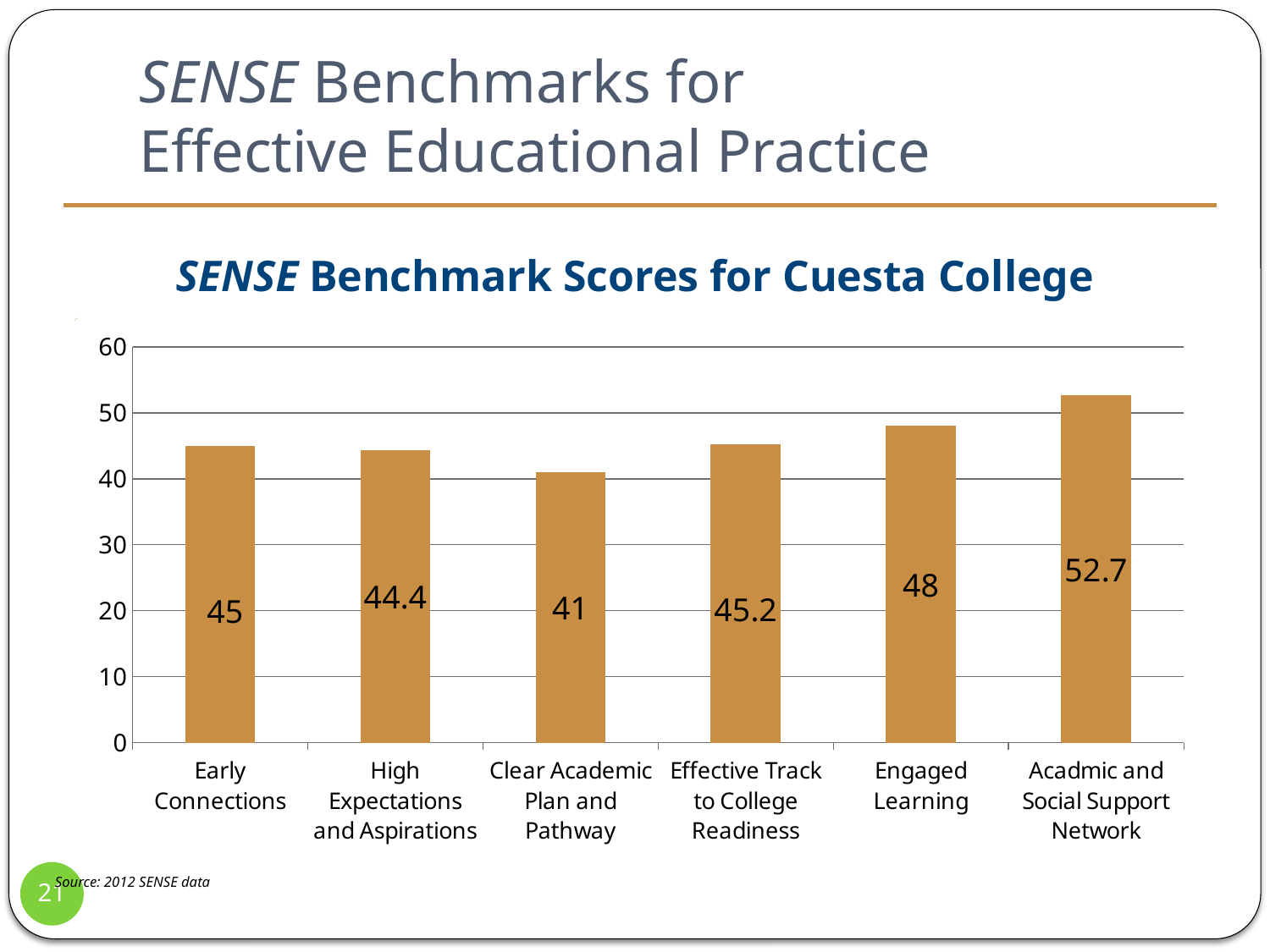
Which has a higher score, Engaged Learning or Early Connections? Engaged Learning Which benchmark has the highest score? Acadmic and Social Support Network What is the score for High Expectations and Aspirations? 44.4 What is the SENSE benchmark score for Early Connections? 45 What is the difference between the scores for Acadmic and Social Support Network and Clear Academic Plan and Pathway? 11.7 Which benchmark has the lowest score? Clear Academic Plan and Pathway How many benchmarks are shown in the chart? 6 Is the score for Acadmic and Social Support Network greater or less than 50? greater What type of chart is shown on the slide? Bar chart What is the score for Clear Academic Plan and Pathway? 41 What is the score for Engaged Learning? 48 What is the difference between the scores for Engaged Learning and Effective Track to College Readiness? 2.8